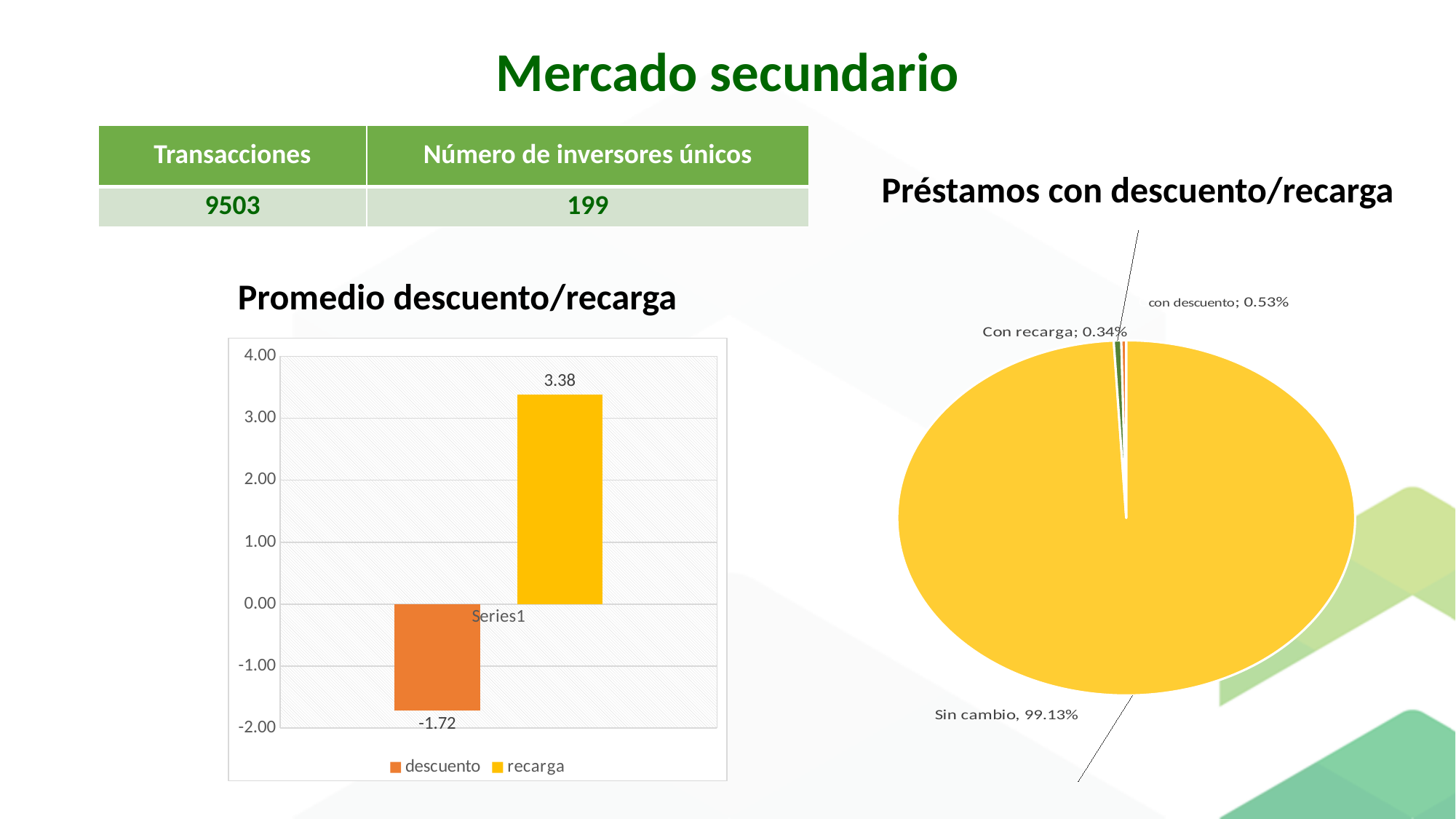
In the 'Promedio descuento/recarga' chart, which series has the higher value, descuento or recarga? recarga In the 'Préstamos con descuento/recarga' chart, what share is labelled 'Sin cambio'? 99.13% In the 'Préstamos con descuento/recarga' chart, what share is labelled 'con descuento'? 0.53% In the 'Promedio descuento/recarga' chart, what is the value for descuento? -1.72 In the 'Préstamos con descuento/recarga' chart, which slice is the largest? Sin cambio What kind of chart is 'Promedio descuento/recarga'? bar chart In the 'Promedio descuento/recarga' chart, what is the difference between the recarga value and the descuento value? 5.10 In the 'Promedio descuento/recarga' chart, how many series does the legend list? 2 In the 'Promedio descuento/recarga' chart, what is the value for recarga? 3.38 In the 'Promedio descuento/recarga' chart, is the value for recarga greater or less than 3.00? greater What kind of chart is 'Préstamos con descuento/recarga'? pie chart In the 'Préstamos con descuento/recarga' chart, what share is labelled 'Con recarga'? 0.34%